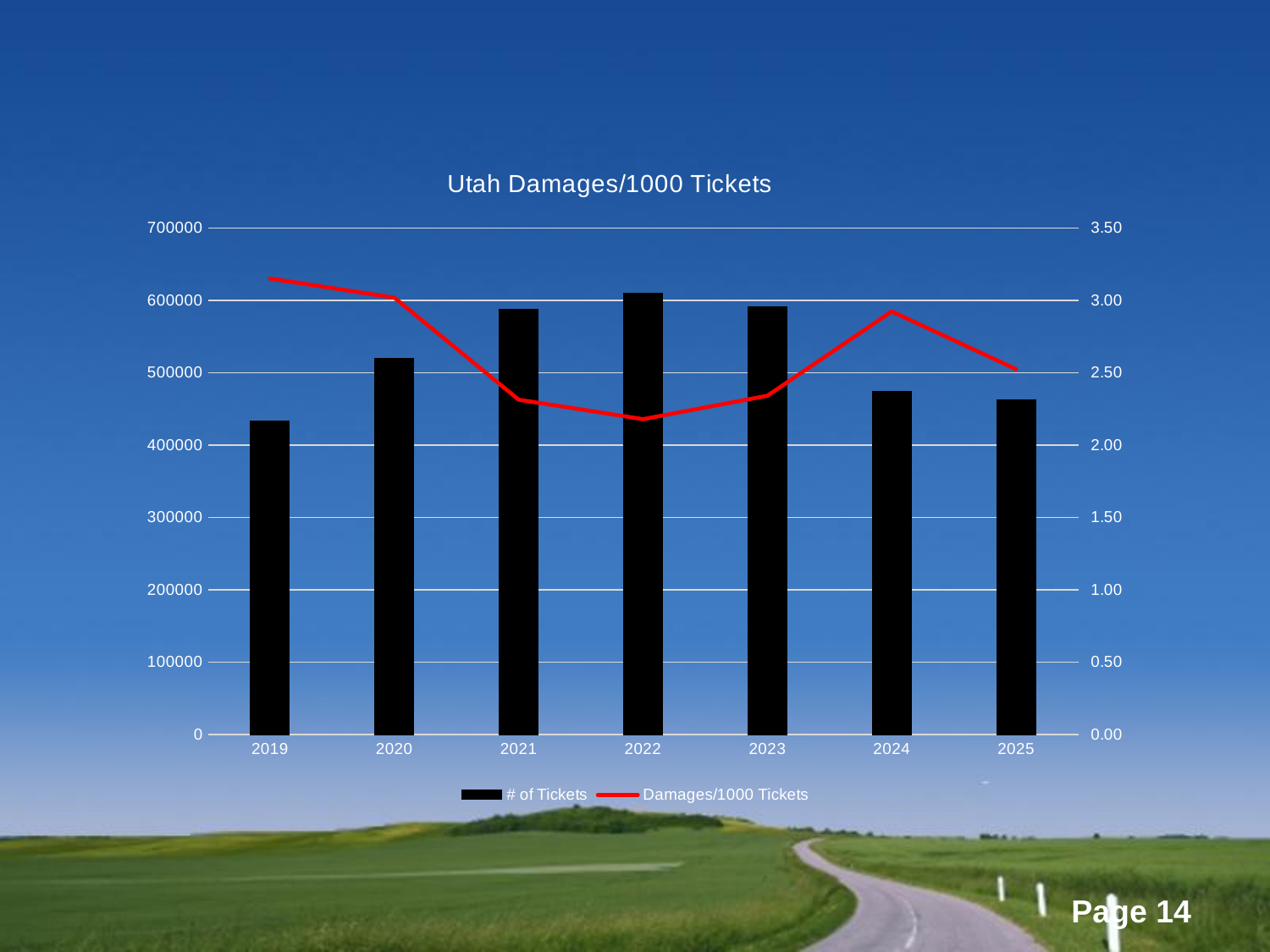
Which year has more tickets, 2020 or 2024? 2020 Does the Damages/1000 Tickets line rise or fall from 2019 to 2022? fall What kind of chart is shown on the slide? A combined bar and line chart Which year has the shortest bar for # of Tickets? 2019 What is the title of the chart? Utah Damages/1000 Tickets How many series does the legend list? 2 Is the # of Tickets value for 2022 greater or less than 600000? greater Is the # of Tickets value for 2019 greater or less than 500000? less How many years are shown on the x axis? 7 Which year has the tallest bar for # of Tickets? 2022 Is the Damages/1000 Tickets value for 2021 greater or less than 2.50? less In which year is the Damages/1000 Tickets line at its highest? 2019